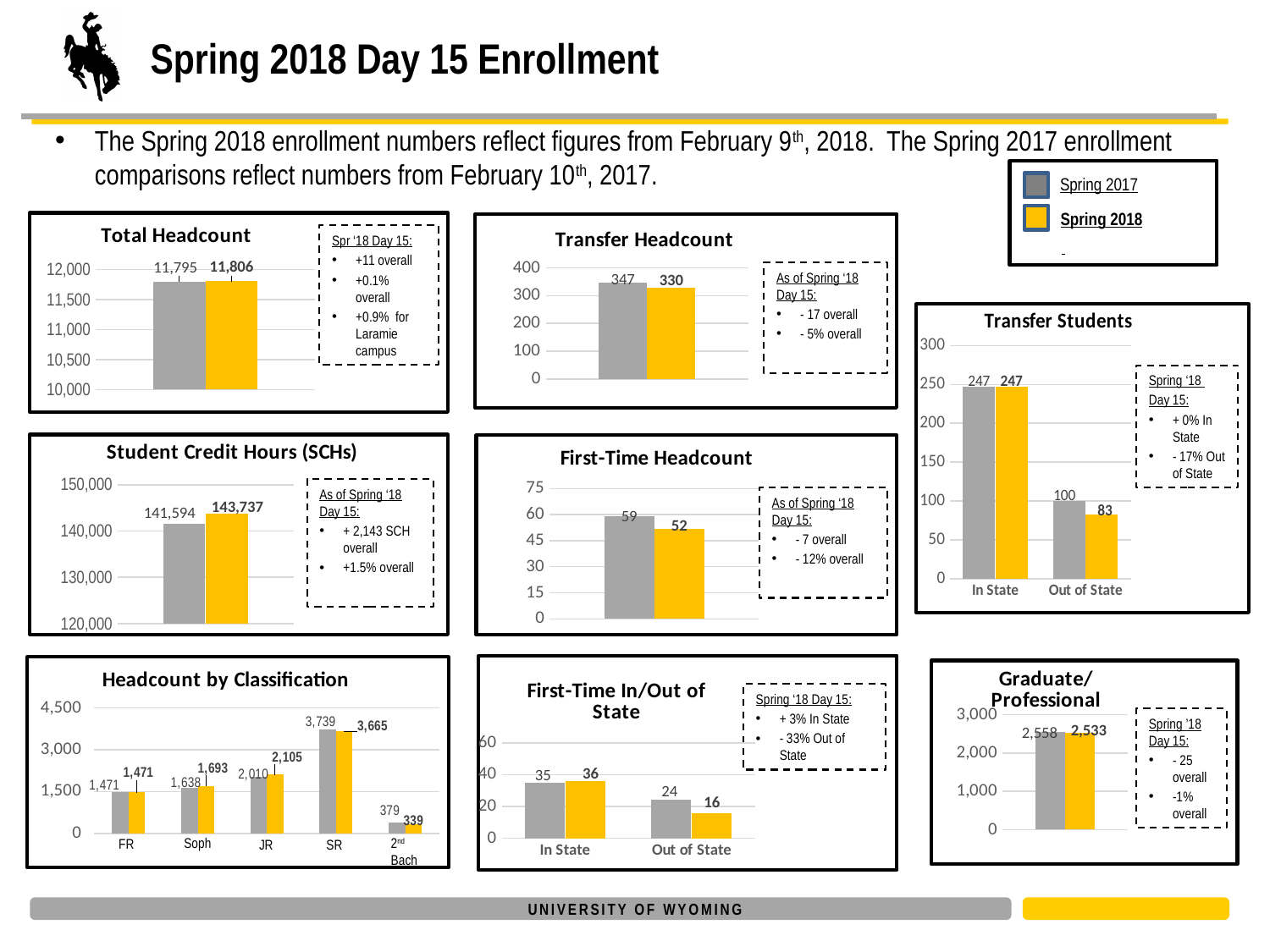
In the First-Time Headcount chart, which is larger, the Spring 2017 value or the Spring 2018 value? Spring 2017 In the Student Credit Hours (SCHs) chart, what is the value for Spring 2018? 143,737 In the Headcount by Classification chart, what is the Spring 2018 value for JR? 2,105 In the Headcount by Classification chart, which classification has the lowest headcount? 2nd Bach How many series does the legend at the top right of the slide list? 2 In the Transfer Headcount chart, what is the value for Spring 2017? 347 In the First-Time In/Out of State chart, what is the difference between the Spring 2017 and Spring 2018 Out of State values? 8 In the Total Headcount chart, what is the value for Spring 2018? 11,806 In the Graduate/Professional chart, what is the value for Spring 2017? 2,558 In the Transfer Students chart, what is the Spring 2018 value for Out of State? 83 In the Headcount by Classification chart, which classification has the highest headcount? SR In the Transfer Headcount chart, what is the difference between the Spring 2017 and Spring 2018 values? 17